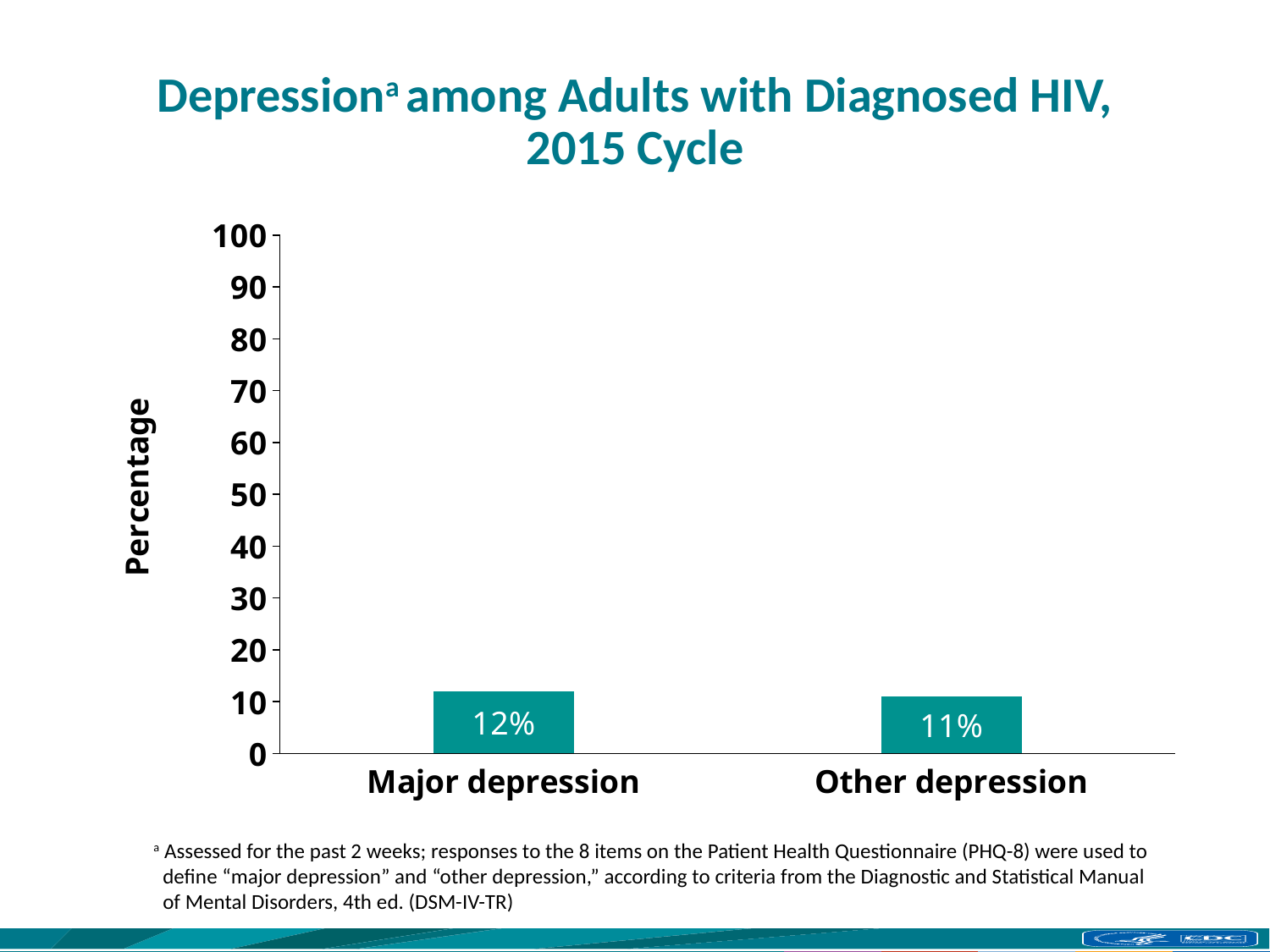
What kind of chart is shown on the slide? Bar chart Which category has the lower percentage? Other depression What is the percentage for Major depression? 12% How many categories are shown on the x axis? 2 What is the difference in percentage points between Major depression and Other depression? 1 What is the label of the y axis? Percentage Is the value for Major depression greater or less than 20? less What is the percentage for Other depression? 11% Which category has the higher percentage? Major depression What is the maximum value shown on the y axis? 100 Is the value for Other depression greater or less than 10? greater